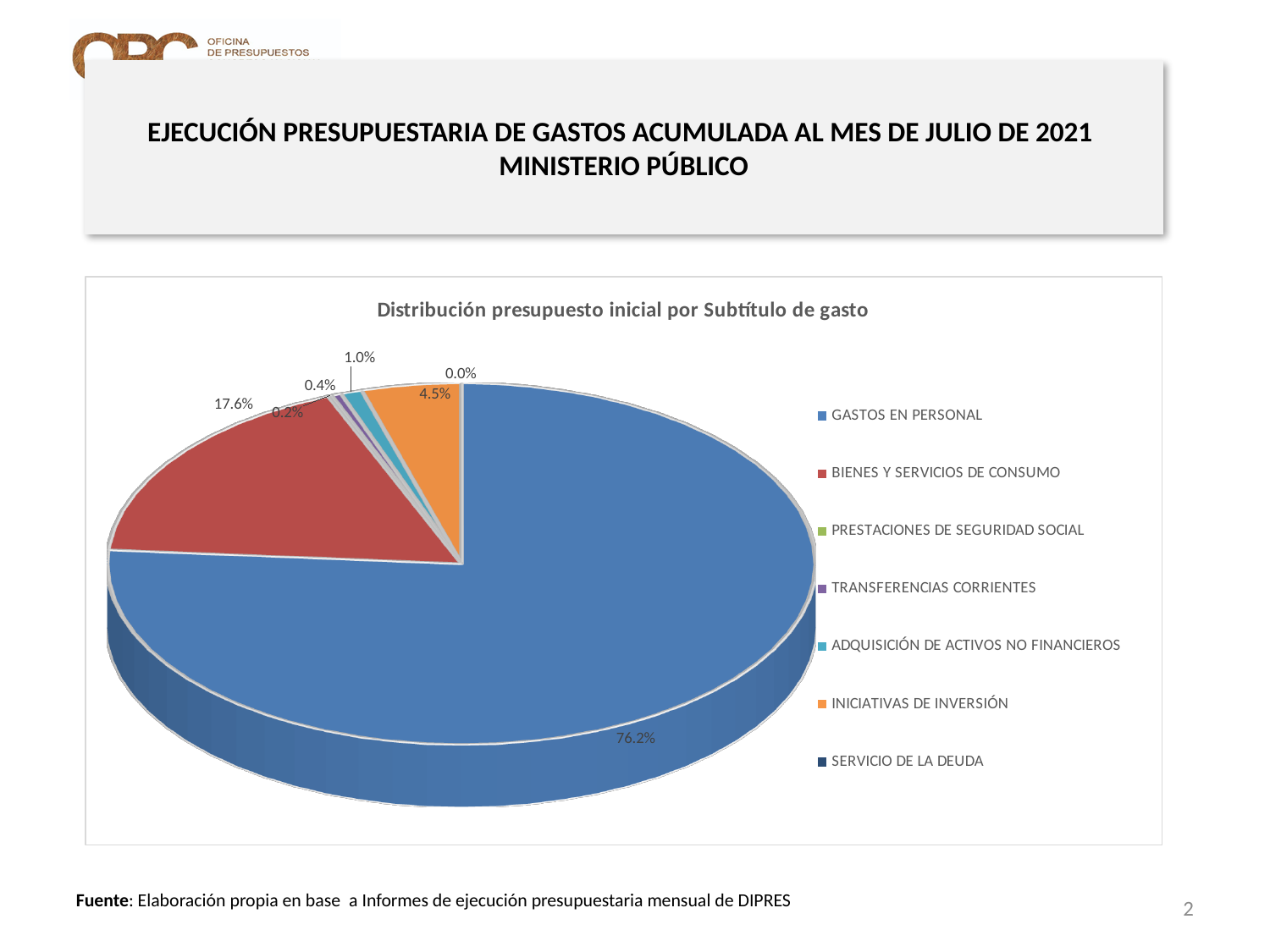
Which is larger, BIENES Y SERVICIOS DE CONSUMO or INICIATIVAS DE INVERSIÓN? BIENES Y SERVICIOS DE CONSUMO What kind of chart is shown on the slide? Pie chart What is the value shown for SERVICIO DE LA DEUDA? 0.0% How many categories does the legend list? 7 What colour is the slice for GASTOS EN PERSONAL? Blue What is the value shown for ADQUISICIÓN DE ACTIVOS NO FINANCIEROS? 1.0% What is the title of the chart? Distribución presupuesto inicial por Subtítulo de gasto What is the value shown for INICIATIVAS DE INVERSIÓN? 4.5% What share of the pie does GASTOS EN PERSONAL represent? 76.2% Which category has the largest slice of the pie? GASTOS EN PERSONAL What share of the pie does BIENES Y SERVICIOS DE CONSUMO represent? 17.6% What is the difference in percentage points between GASTOS EN PERSONAL and BIENES Y SERVICIOS DE CONSUMO? 58.6 percentage points